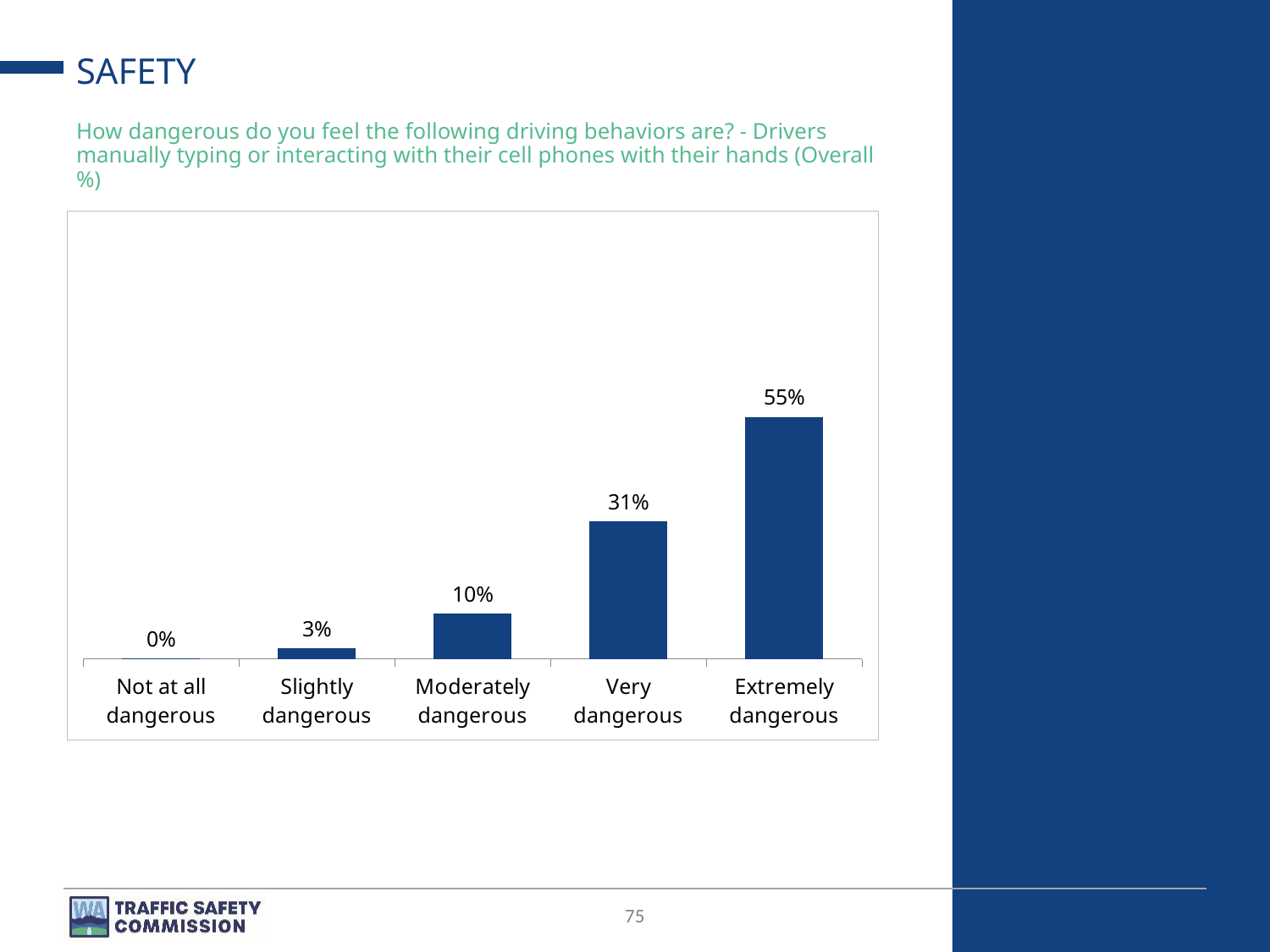
What is the difference between the values for "Extremely dangerous" and "Very dangerous"? 24% What is the value shown for "Not at all dangerous"? 0% Do the values rise or fall moving from left to right along the x axis? Rise What percentage of respondents rated drivers manually typing or interacting with their cell phones as "Extremely dangerous"? 55% How many categories are shown on the x axis? 5 What kind of chart is shown on the slide? Bar chart Which category has the highest value? Extremely dangerous Which is larger, the value for "Moderately dangerous" or the value for "Slightly dangerous"? Moderately dangerous What is the value shown for "Moderately dangerous"? 10% What is the value shown for "Very dangerous"? 31% Which category has the lowest value? Not at all dangerous What is the value shown for "Slightly dangerous"? 3%